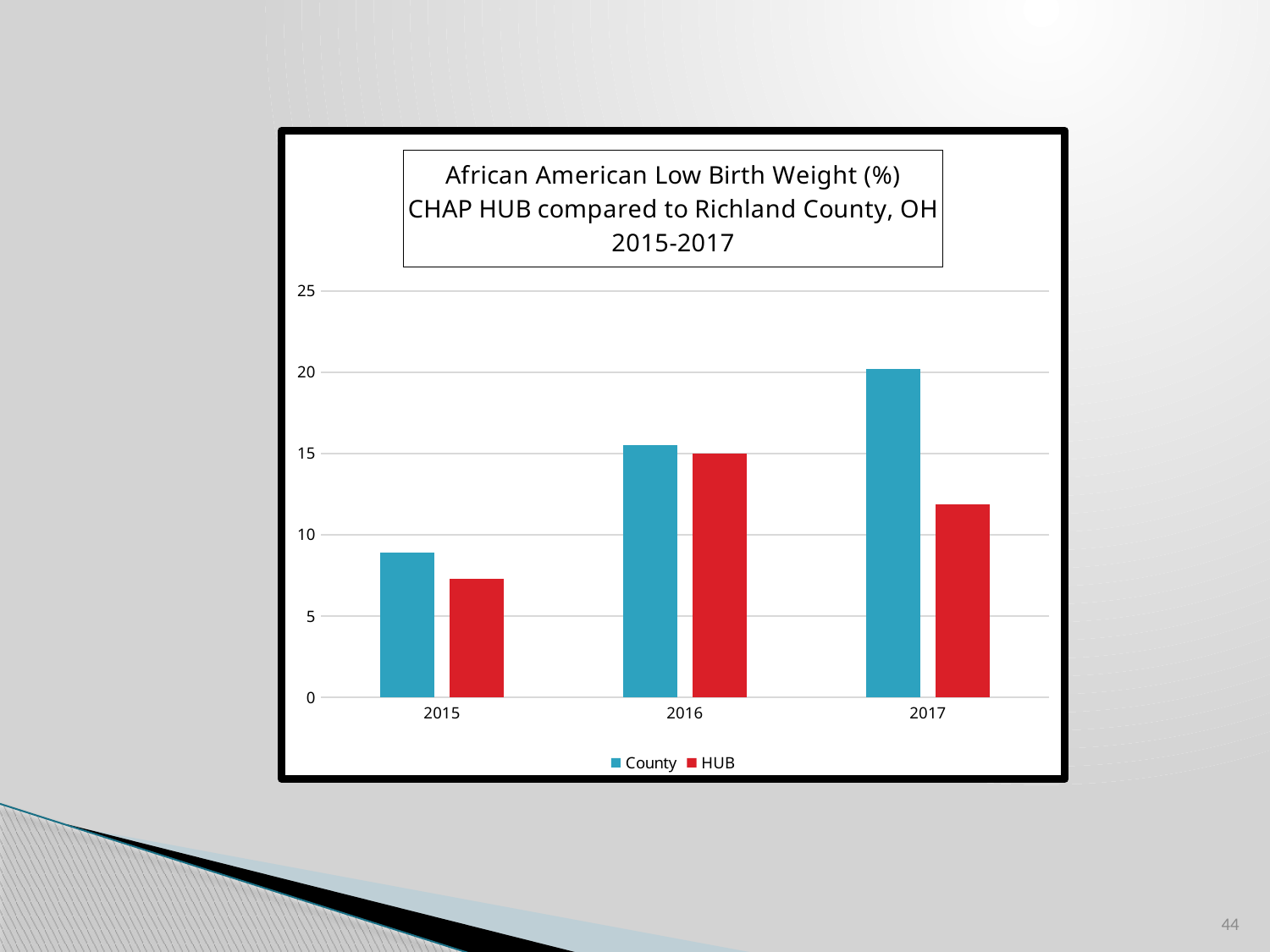
Do the County values rise or fall from 2015 to 2017? rise How many years are shown on the x axis? 3 Is the County value for 2015 greater or less than 10? less In 2017, which is larger, the County value or the HUB value? County In which year is the County value highest? 2017 Is the HUB value for 2017 greater or less than 15? less What kind of chart is shown on the slide? bar chart In which year is the HUB value highest? 2016 How many series does the legend list? 2 In which year is the HUB value lowest? 2015 Which colour represents the HUB series in the legend? red In 2015, which is larger, the County value or the HUB value? County